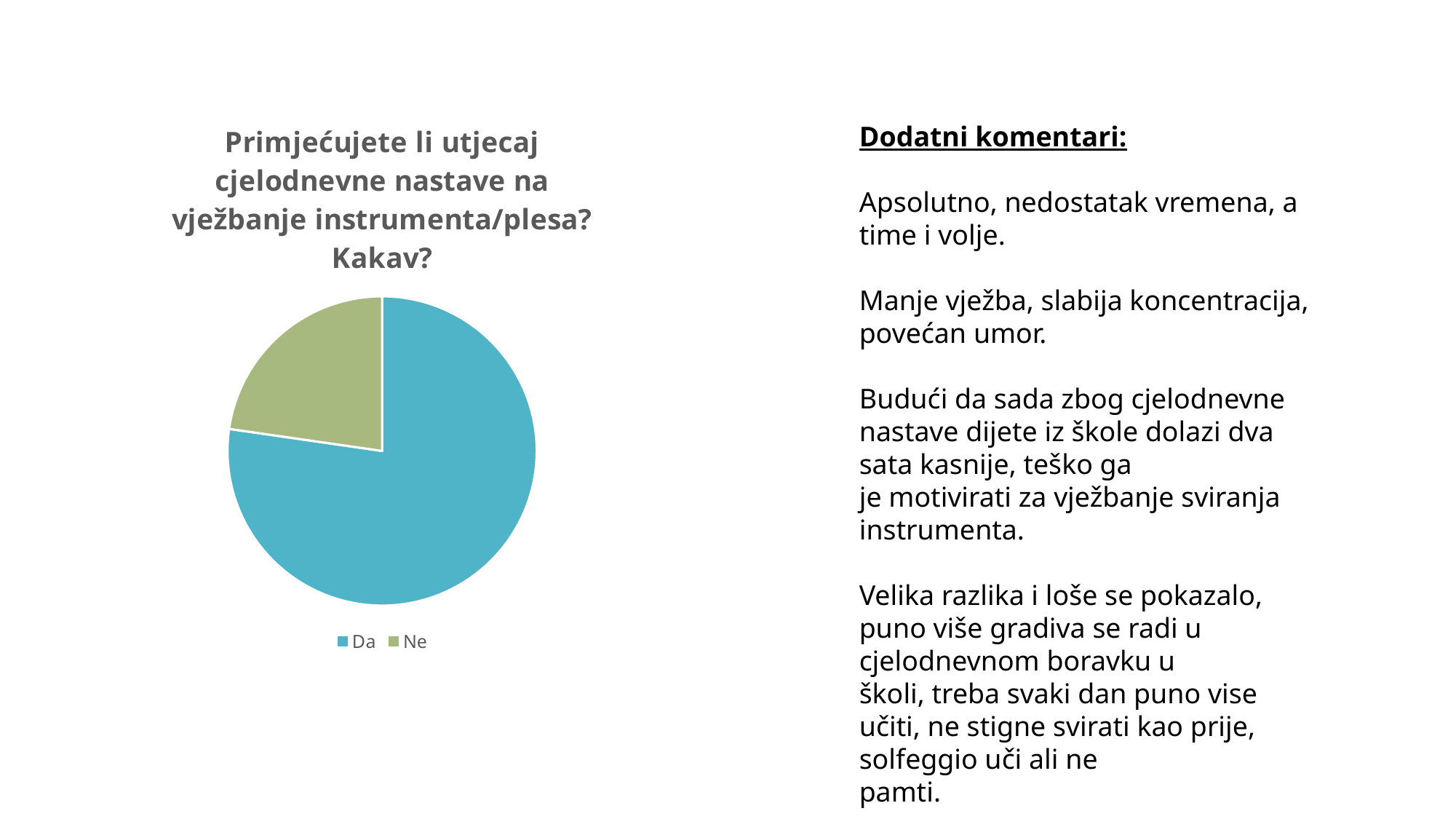
Which category has the smallest slice in the pie chart? Ne What kind of chart is shown on the slide? pie chart Does the Da slice take up more or less than half of the pie chart? more How many entries does the legend of the pie chart list? 2 Which slice is larger in the pie chart, Da or Ne? Da Which category has the largest slice in the pie chart? Da What colour is the Ne slice in the pie chart? green What is the title of the pie chart? Primjećujete li utjecaj cjelodnevne nastave na vježbanje instrumenta/plesa? Kakav? How many slices does the pie chart have? 2